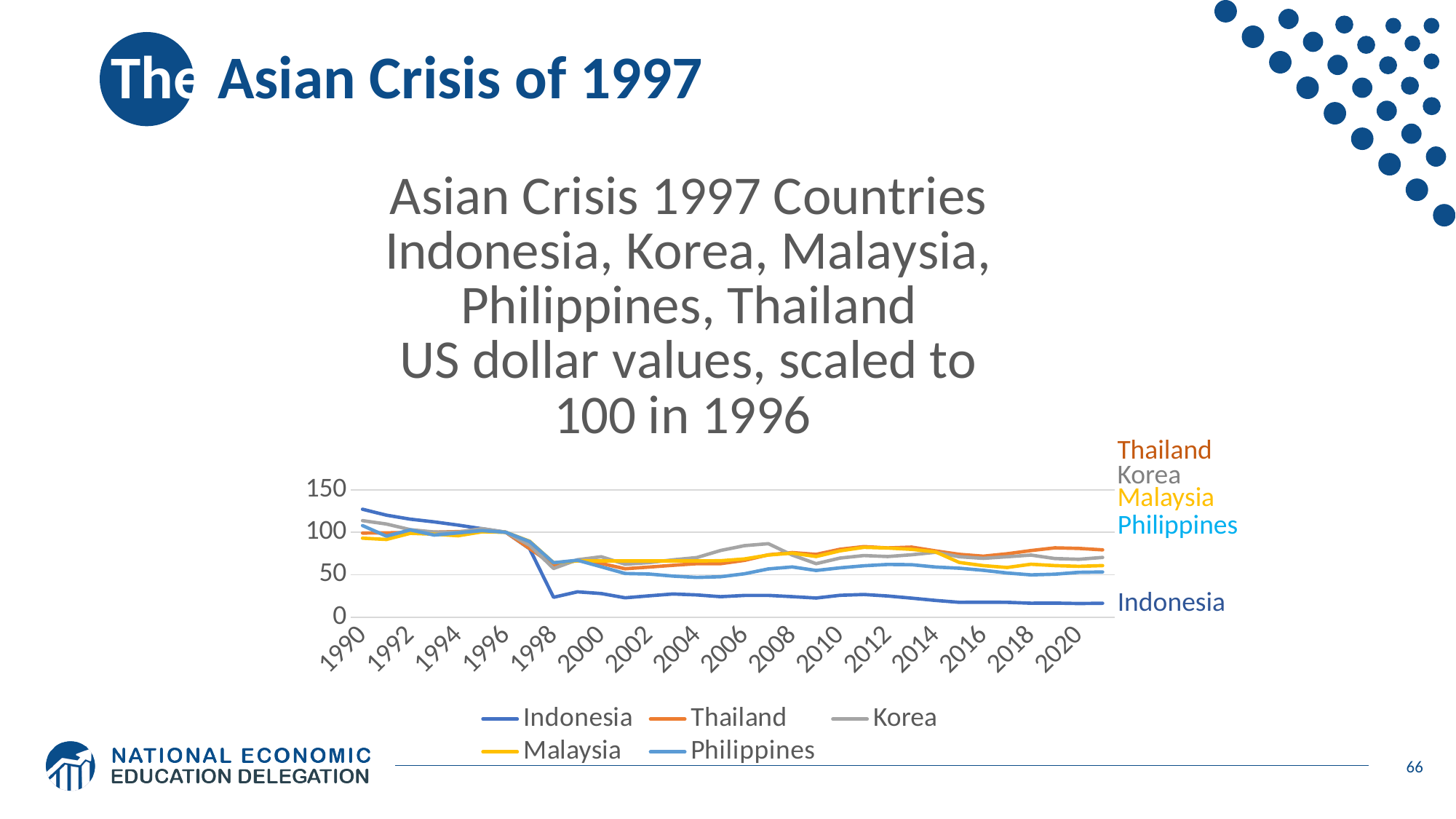
Is the value for Thailand in 2020 greater or less than 50? greater Which countries are listed in the chart legend? Indonesia, Thailand, Korea, Malaysia, Philippines In 2020, which is larger: the value for Thailand or the value for Indonesia? Thailand How many series does the chart legend list? 5 In what year are all the series scaled to 100? 1996 Is the value for Indonesia in 1990 greater or less than 100? greater Which country has the highest value in 1990? Indonesia Is the value for Indonesia in 2020 greater or less than 50? less What is the value for Indonesia in 1996? 100 What kind of chart is shown on the slide? line chart Which country has the lowest value in 2020? Indonesia Does the value for Indonesia rise or fall between 1996 and 1998? fall